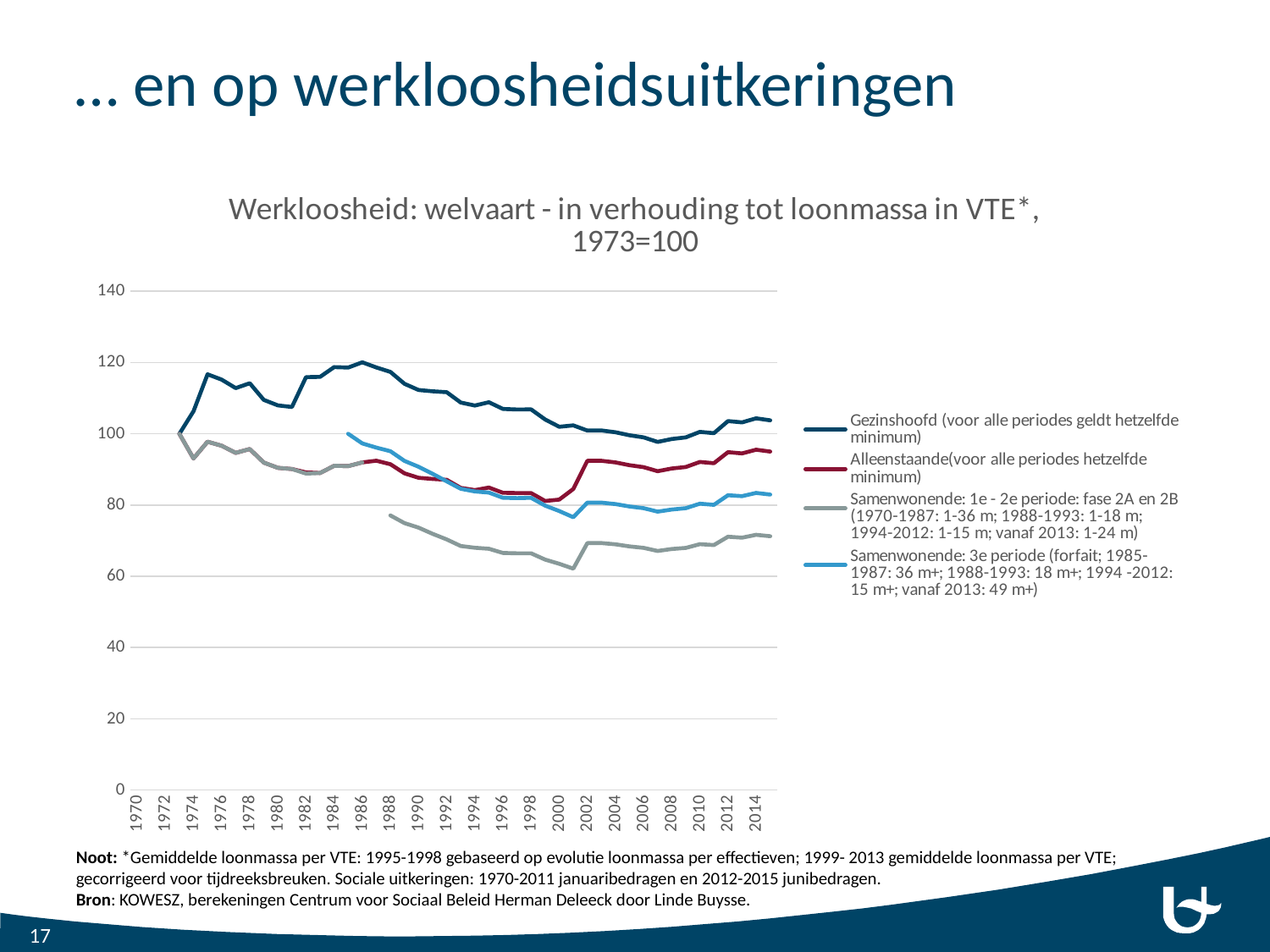
Is the value for Samenwonende: 3e periode in 1986 greater or less than 80? greater Is the value for Gezinshoofd in 1986 greater or less than 100? greater In 2014, which is higher: Gezinshoofd or Samenwonende: 1e - 2e periode? Gezinshoofd What is the title of the chart? Werkloosheid: welvaart - in verhouding tot loonmassa in VTE*, 1973=100 Which year is used as the base year (=100) according to the chart title? 1973 Which series has the highest value in 2014? Gezinshoofd What kind of chart is shown on the slide? line chart How many series does the legend list? 4 Is the value for Samenwonende: 1e - 2e periode in 2000 greater or less than 80? less Which series has the lowest value in 2000? Samenwonende: 1e - 2e periode Does the Gezinshoofd series rise or fall between 1986 and 2008? fall